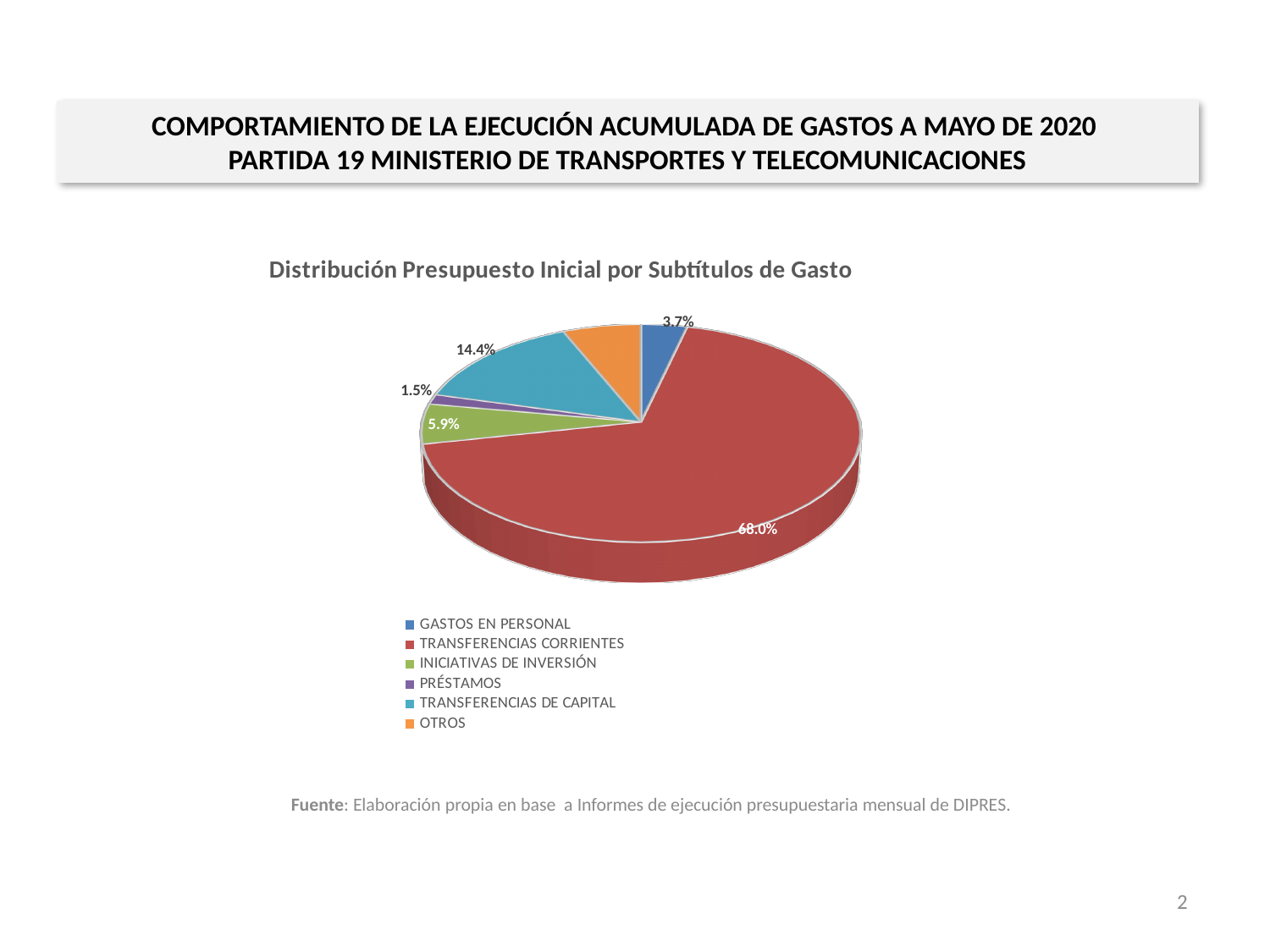
What share of the pie does PRÉSTAMOS represent? 1.5% What kind of chart is shown on the slide? Pie chart What share of the pie does TRANSFERENCIAS CORRIENTES represent? 68.0% Which category has the largest share of the pie? TRANSFERENCIAS CORRIENTES What share of the pie does GASTOS EN PERSONAL represent? 3.7% Which has a larger share, INICIATIVAS DE INVERSIÓN or GASTOS EN PERSONAL? INICIATIVAS DE INVERSIÓN What is the title of the chart? Distribución Presupuesto Inicial por Subtítulos de Gasto How many categories does the legend list? 6 What share of the pie does TRANSFERENCIAS DE CAPITAL represent? 14.4% What share of the pie does INICIATIVAS DE INVERSIÓN represent? 5.9% What is the difference in percentage points between TRANSFERENCIAS CORRIENTES and TRANSFERENCIAS DE CAPITAL? 53.6 Which category has the smallest share of the pie? PRÉSTAMOS